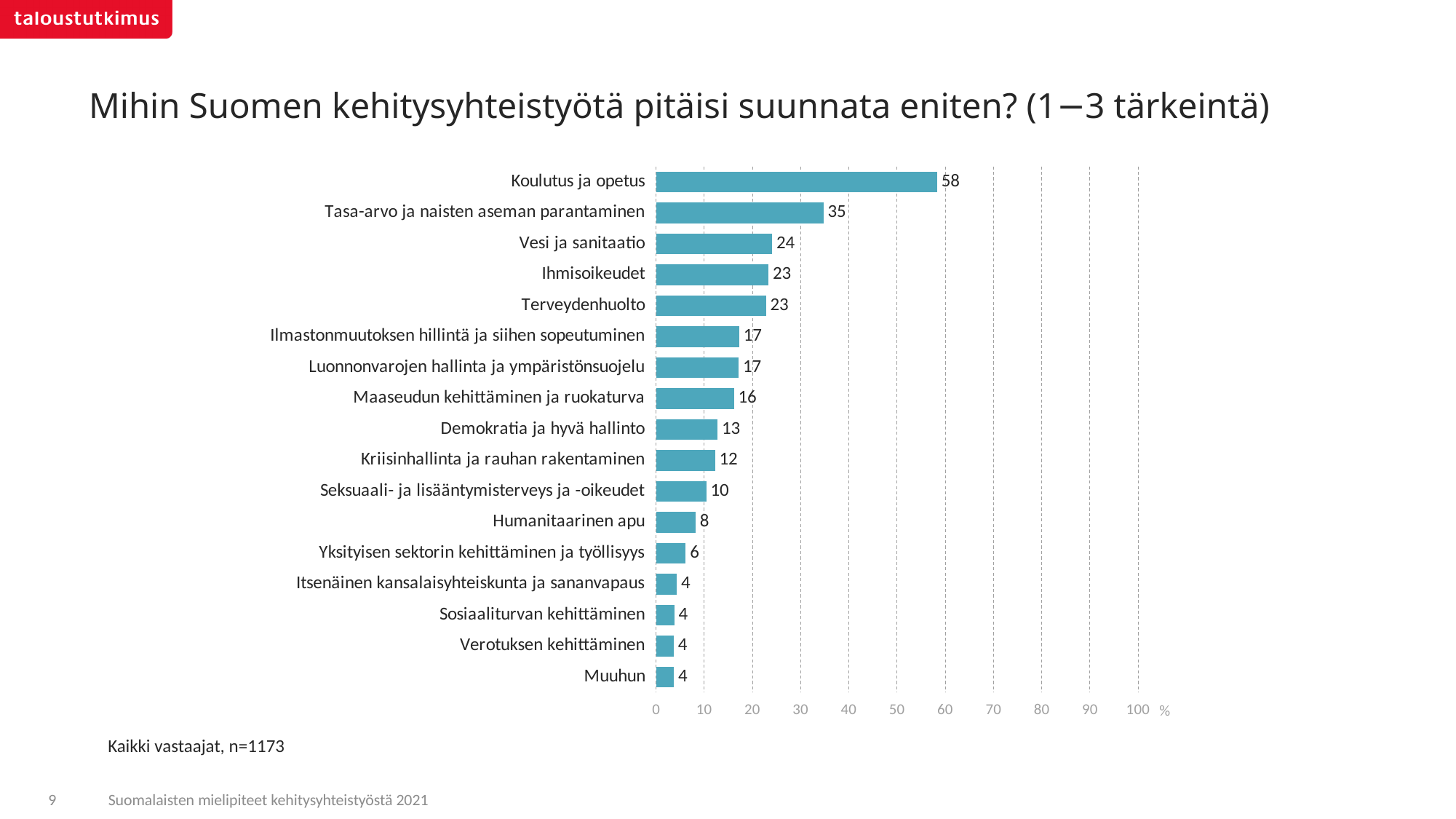
What is the value for Humanitaarinen apu? 8 What is the value for Koulutus ja opetus? 58 What is the difference between the values for Koulutus ja opetus and Tasa-arvo ja naisten aseman parantaminen? 23 What is the difference between the values for Vesi ja sanitaatio and Demokratia ja hyvä hallinto? 11 Is the value for Koulutus ja opetus greater or less than 50? greater What is the value for Tasa-arvo ja naisten aseman parantaminen? 35 What is the value for Maaseudun kehittäminen ja ruokaturva? 16 Which is larger, the value for Kriisinhallinta ja rauhan rakentaminen or the value for Yksityisen sektorin kehittäminen ja työllisyys? Kriisinhallinta ja rauhan rakentaminen Which category has the highest value? Koulutus ja opetus How many categories are shown in the chart? 17 What kind of chart is shown on the slide? bar chart What is the title of the chart? Mihin Suomen kehitysyhteistyötä pitäisi suunnata eniten? (1−3 tärkeintä)